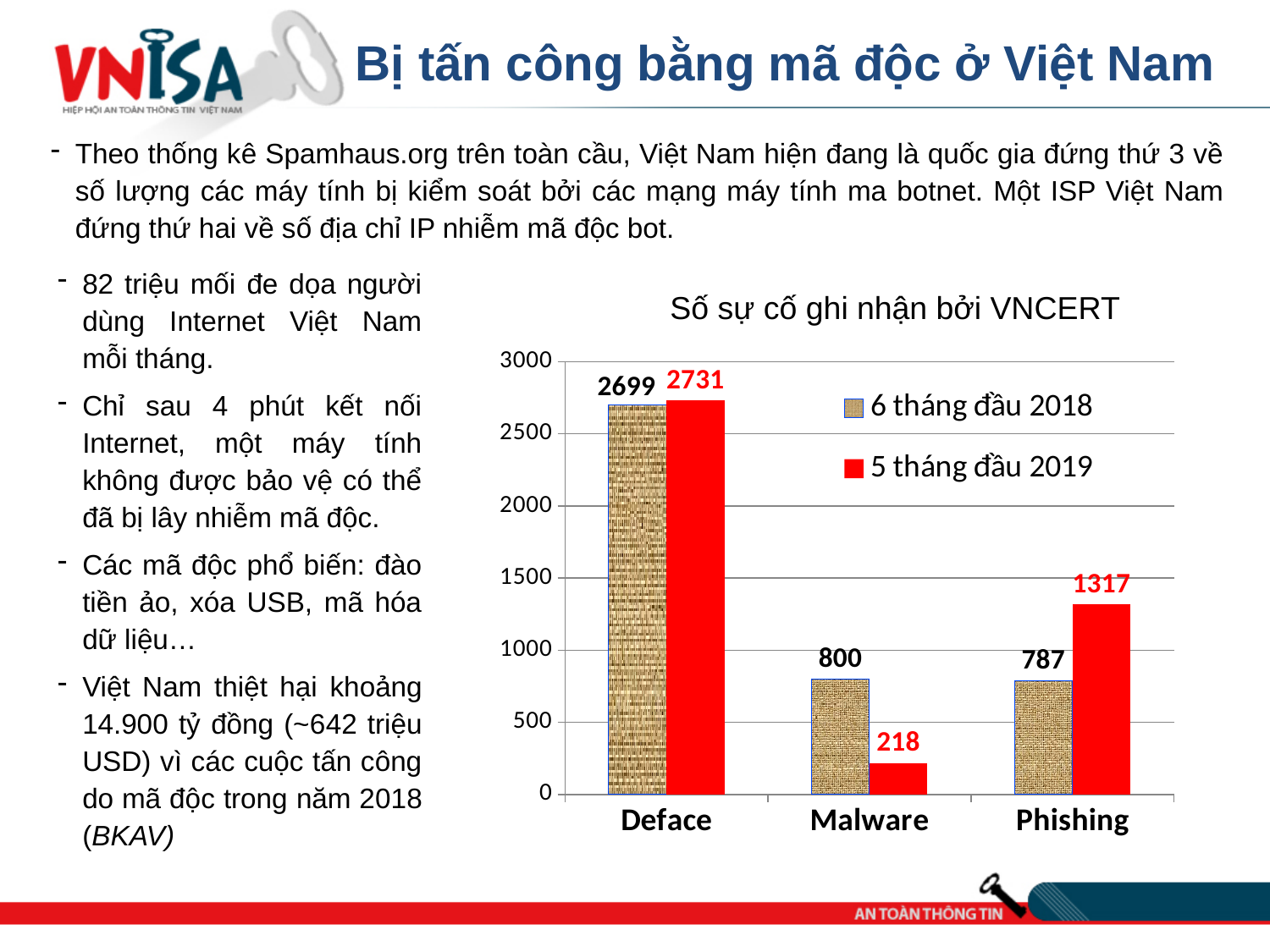
What is the difference between the Malware values for '6 tháng đầu 2018' and '5 tháng đầu 2019'? 582 Which category has the highest value in the '5 tháng đầu 2019' series? Deface What is the difference between the Phishing values for '5 tháng đầu 2019' and '6 tháng đầu 2018'? 530 How many series does the legend list? 2 Which is larger for Deface: the '6 tháng đầu 2018' value or the '5 tháng đầu 2019' value? 5 tháng đầu 2019 What kind of chart is shown on the slide? Bar chart What is the title of the chart? Số sự cố ghi nhận bởi VNCERT How many categories are shown on the x axis of the chart? 3 What is the value for Malware in the '5 tháng đầu 2019' series? 218 What is the value for Deface in the '6 tháng đầu 2018' series? 2699 What is the value for Phishing in the '5 tháng đầu 2019' series? 1317 Which category has the lowest value in the '5 tháng đầu 2019' series? Malware